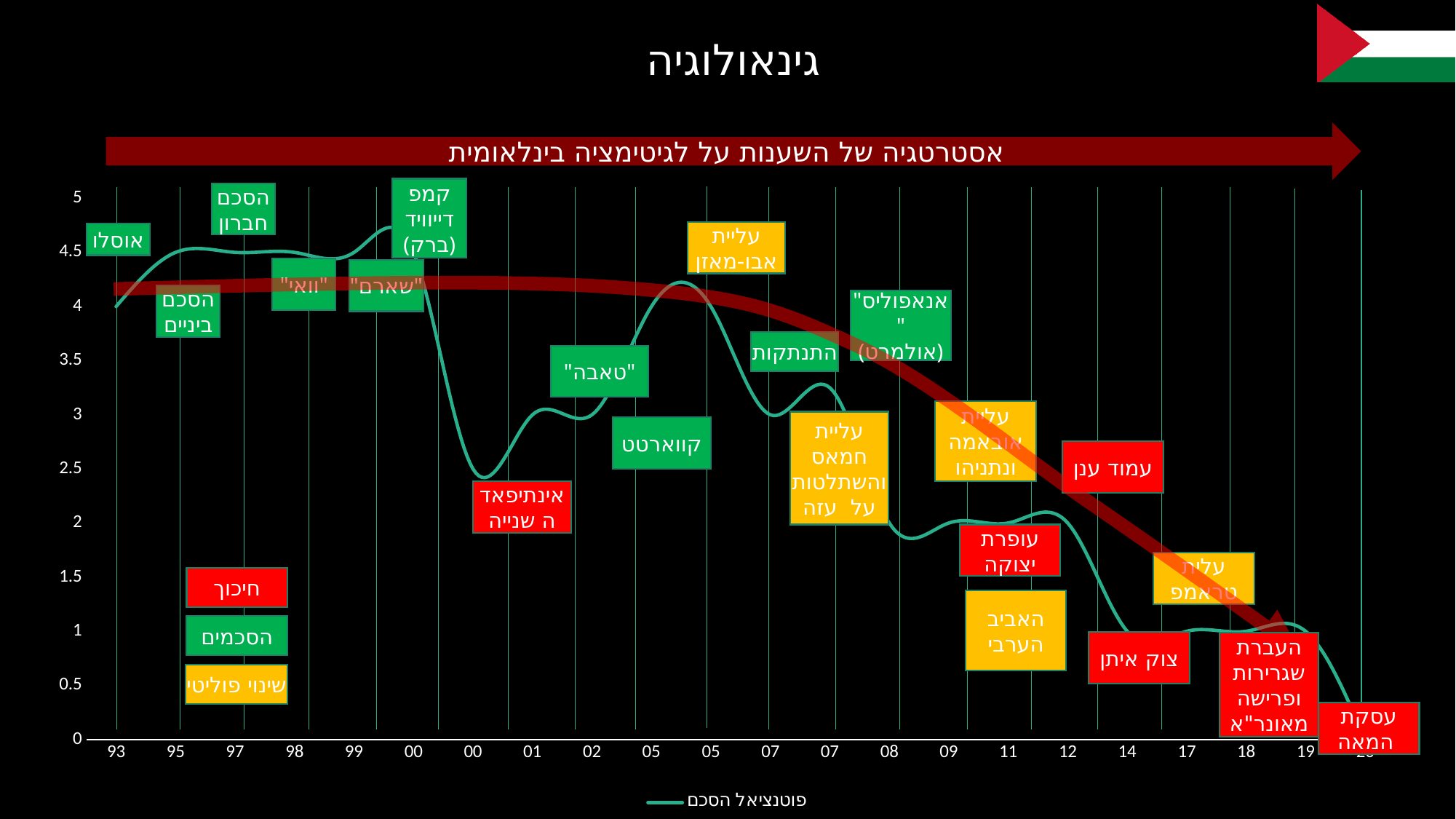
Is the value for 18 greater or less than 1.5? less What is the name of the series shown in the legend? פוטנציאל הסכם What kind of chart is shown on the slide? line chart Is the value for 01 greater or less than 3.5? less Which has the larger value, 08 or 18? 08 What is the title of the slide? גינאולוגיה Overall, do the values of the line rise or fall from left to right along the x axis? fall Is the value for 11 greater or less than 2.5? less How many series does the legend list? 1 Which x-axis label has the lowest value on the line? 20 Which has the larger value, 99 or 01? 99